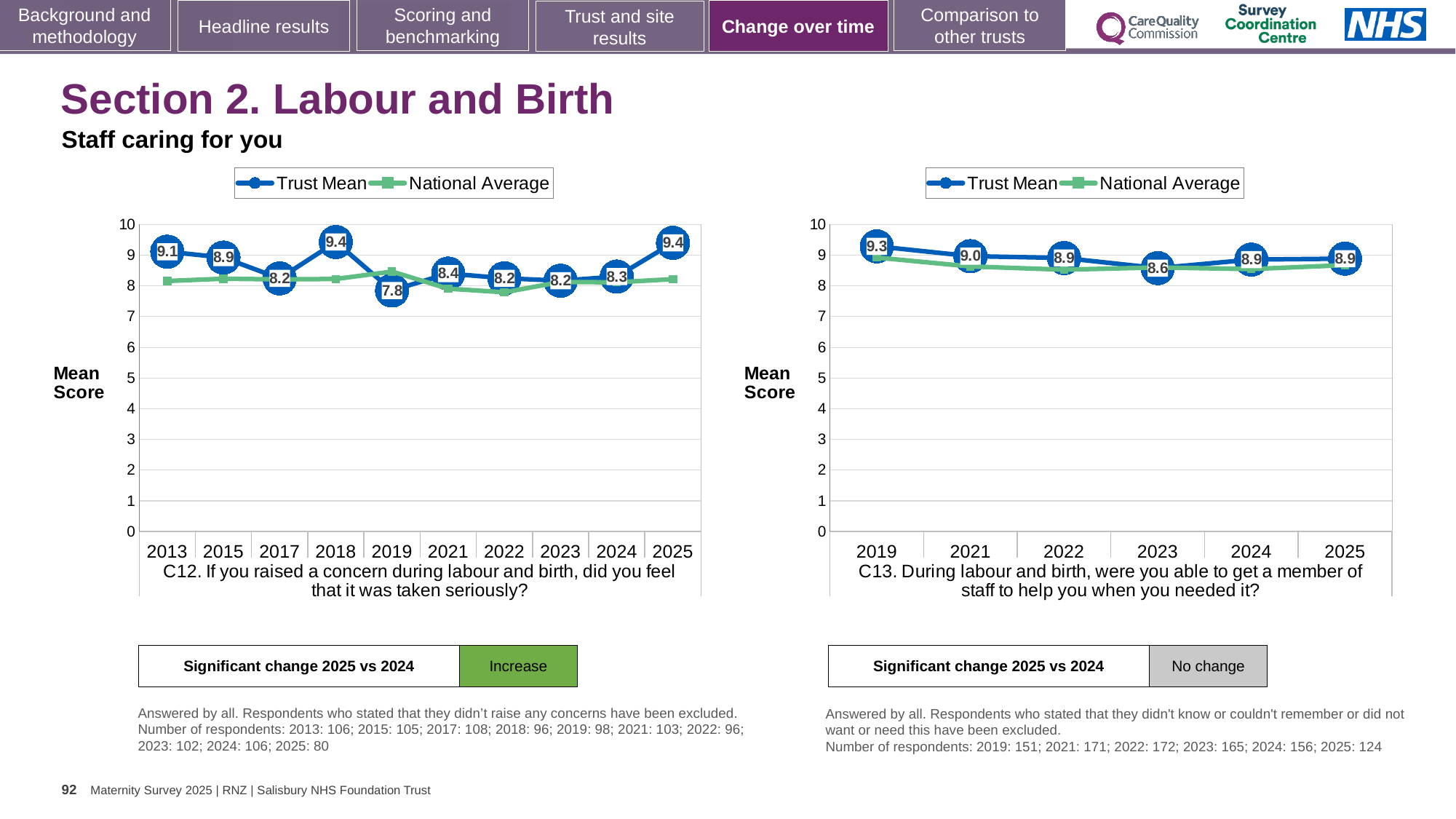
In the C12 chart on the left, which year has the lowest Trust Mean? 2019 What type of chart is the C12 chart on the left? Line chart In the C13 chart on the right, what is the Trust Mean for 2021? 9.0 How many years are plotted in the C13 chart on the right? 6 In the C13 chart on the right, what is the difference between the Trust Mean for 2019 and for 2023? 0.7 In the C13 chart on the right, which year has the highest Trust Mean? 2019 In the C12 chart on the left, what is the Trust Mean for 2019? 7.8 In the C12 chart on the left, what is the difference between the Trust Mean for 2025 and for 2024? 1.1 In the C12 chart on the left, what is the Trust Mean for 2025? 9.4 In the C13 chart on the right, which year has the lowest Trust Mean? 2023 In the C12 chart on the left, is the Trust Mean higher in 2018 or in 2019? 2018 In the C12 chart on the left, is the National Average for 2019 greater or less than 8? greater